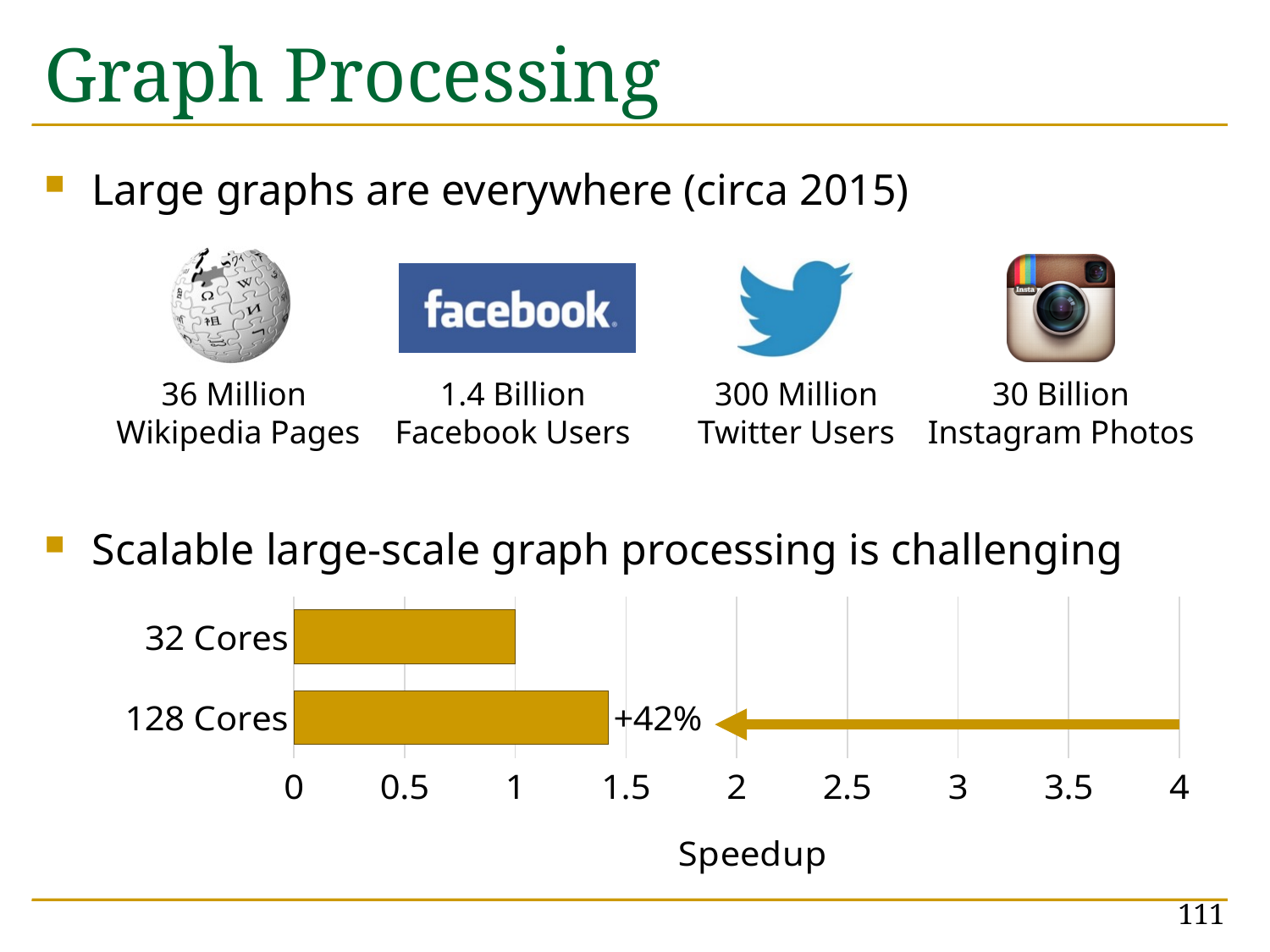
Is the speedup for 128 Cores greater or less than 2? less Is the speedup for 128 Cores greater or less than 1? greater What is the speedup value for 32 Cores? 1 Which category has the lowest speedup? 32 Cores Which category has the highest speedup? 128 Cores What is the label of the x axis of the bar chart? Speedup Is the speedup for 32 Cores greater or less than 2? less What annotation is printed next to the 128 Cores bar? +42% Which has a larger speedup, 32 Cores or 128 Cores? 128 Cores How many categories are plotted in the bar chart? 2 What kind of chart is shown on the slide? bar chart